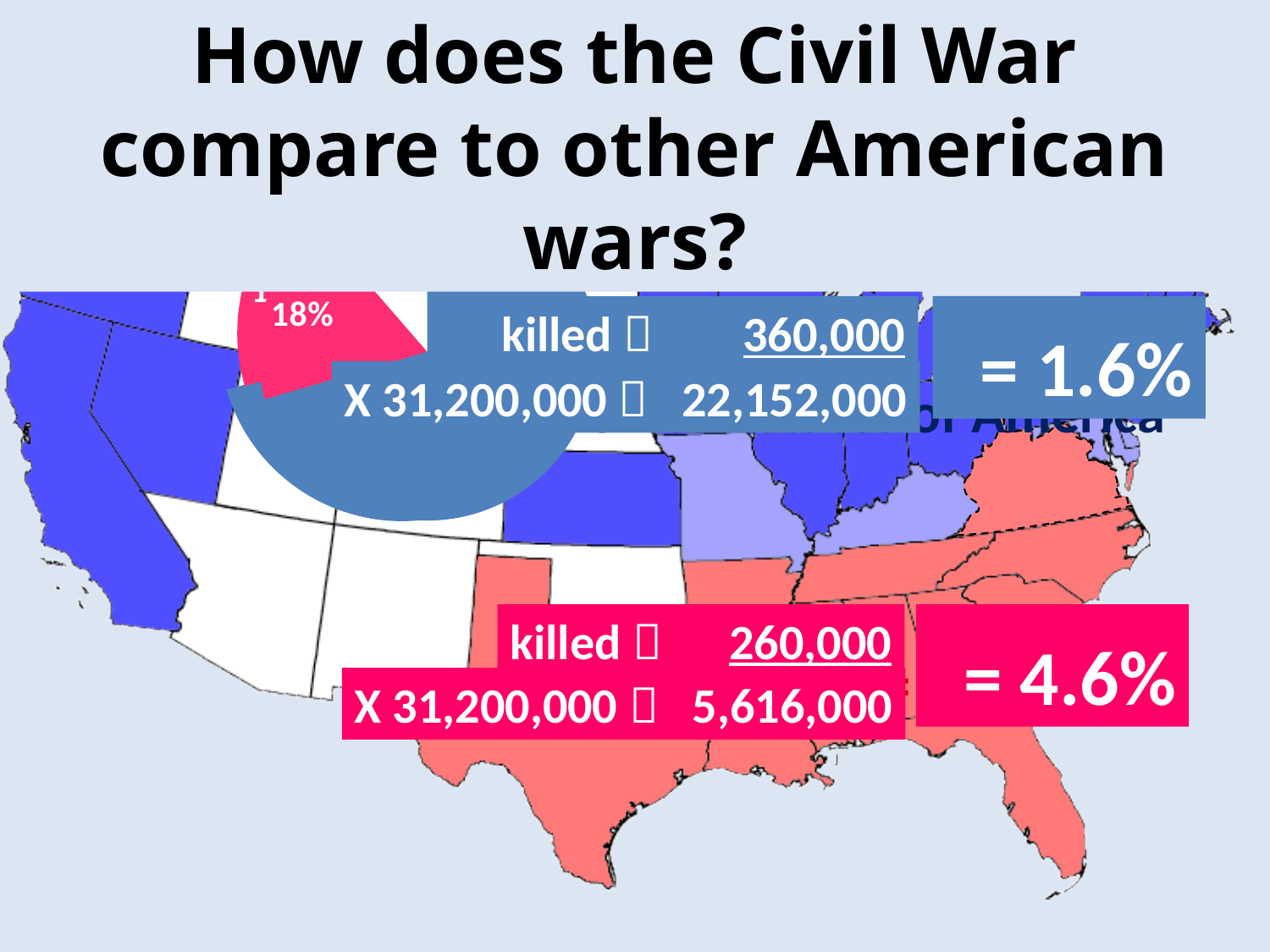
What percentage label is printed on the pink slice of the pie chart? 18% What share of the pie chart does the pink slice represent? 18% What kind of chart is partially visible on the slide behind the text boxes? pie chart Which slice of the pie chart is larger, the pink slice or the blue slice? blue Is the share of the pink slice in the pie chart greater or less than 50%? less How many differently coloured slices are visible in the pie chart? 2 What colour is the slice of the pie chart labelled 18%? pink